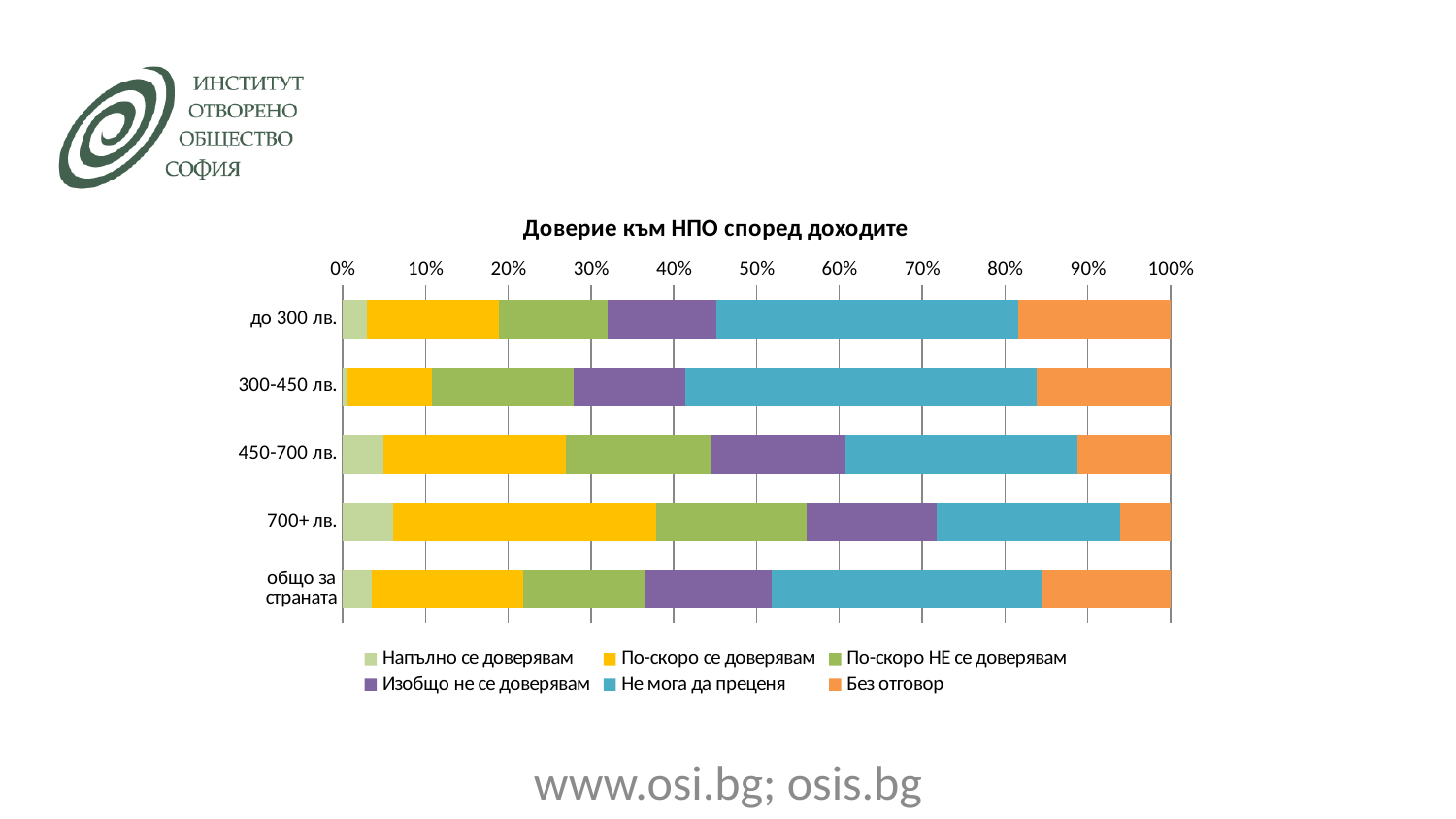
Is the "По-скоро се доверявам" value for "300-450 лв." greater or less than 20%? less Is the "Напълно се доверявам" value for "700+ лв." greater or less than 10%? less Which income group has the smallest "Без отговор" segment? 700+ лв. How many income categories are shown on the chart? 5 Which income group has the smallest "Не мога да преценя" segment? 700+ лв. Is the "По-скоро се доверявам" value for "700+ лв." greater or less than 20%? greater Which income group has the largest "По-скоро се доверявам" segment? 700+ лв. Which series is shown in orange in the legend? Без отговор How many series does the legend list? 6 Is the "По-скоро се доверявам" segment larger for "700+ лв." or for "до 300 лв."? 700+ лв. What kind of chart is shown on the slide? Stacked bar chart What is the title of the chart? Доверие към НПО според доходите